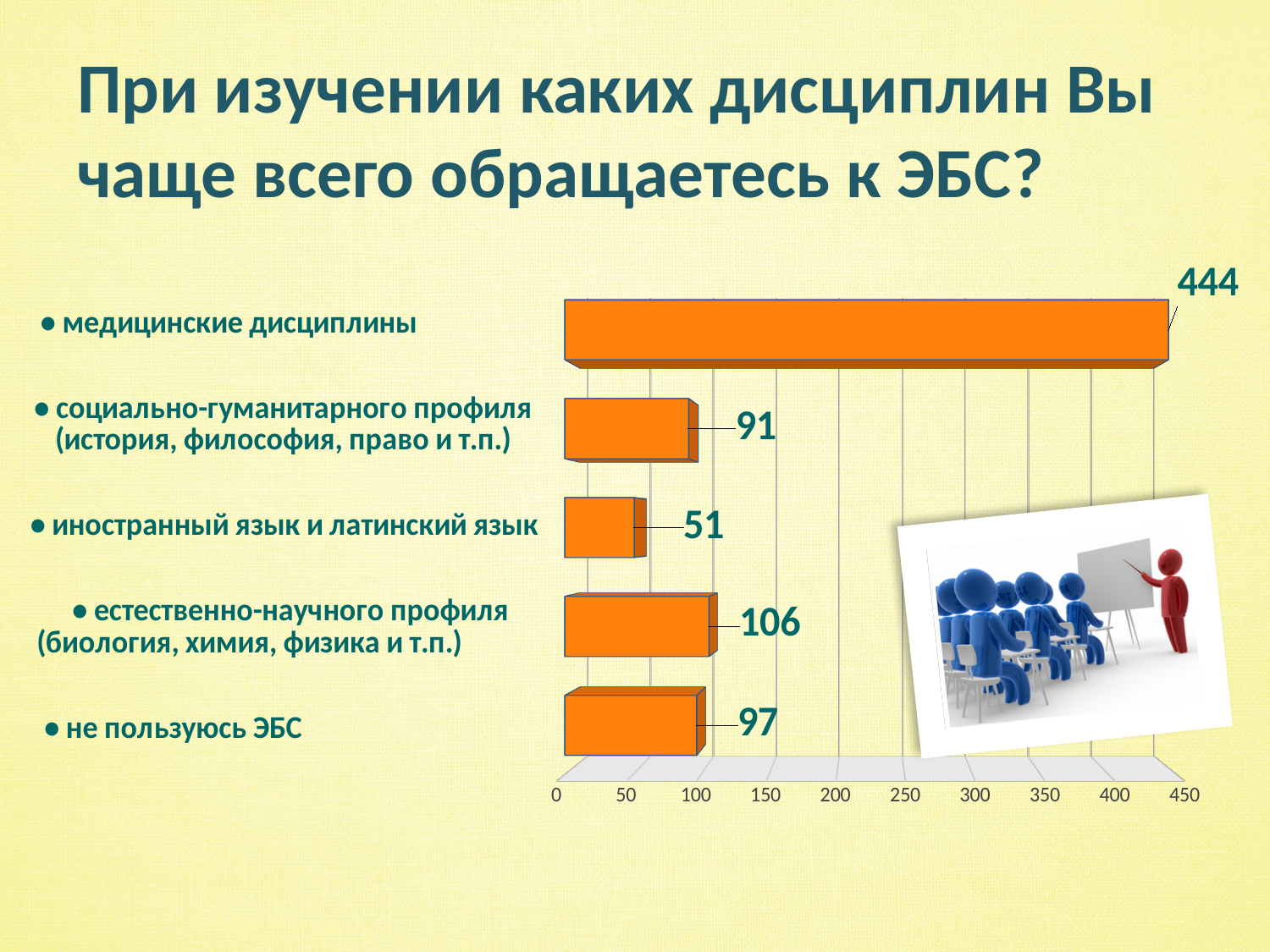
What is the difference between the values for медицинские дисциплины and естественно-научного профиля? 338 What is the value for не пользуюсь ЭБС? 97 Which category has the highest value? медицинские дисциплины Which category has the lowest value? иностранный язык и латинский язык What is the value for иностранный язык и латинский язык? 51 How many categories are shown in the chart? 5 What is the title of the slide? При изучении каких дисциплин Вы чаще всего обращаетесь к ЭБС? What is the value for медицинские дисциплины? 444 What is the value for естественно-научного профиля (биология, химия, физика и т.п.)? 106 What is the value for социально-гуманитарного профиля (история, философия, право и т.п.)? 91 What kind of chart is shown on the slide? bar chart Which is larger, the value for не пользуюсь ЭБС or the value for социально-гуманитарного профиля? не пользуюсь ЭБС